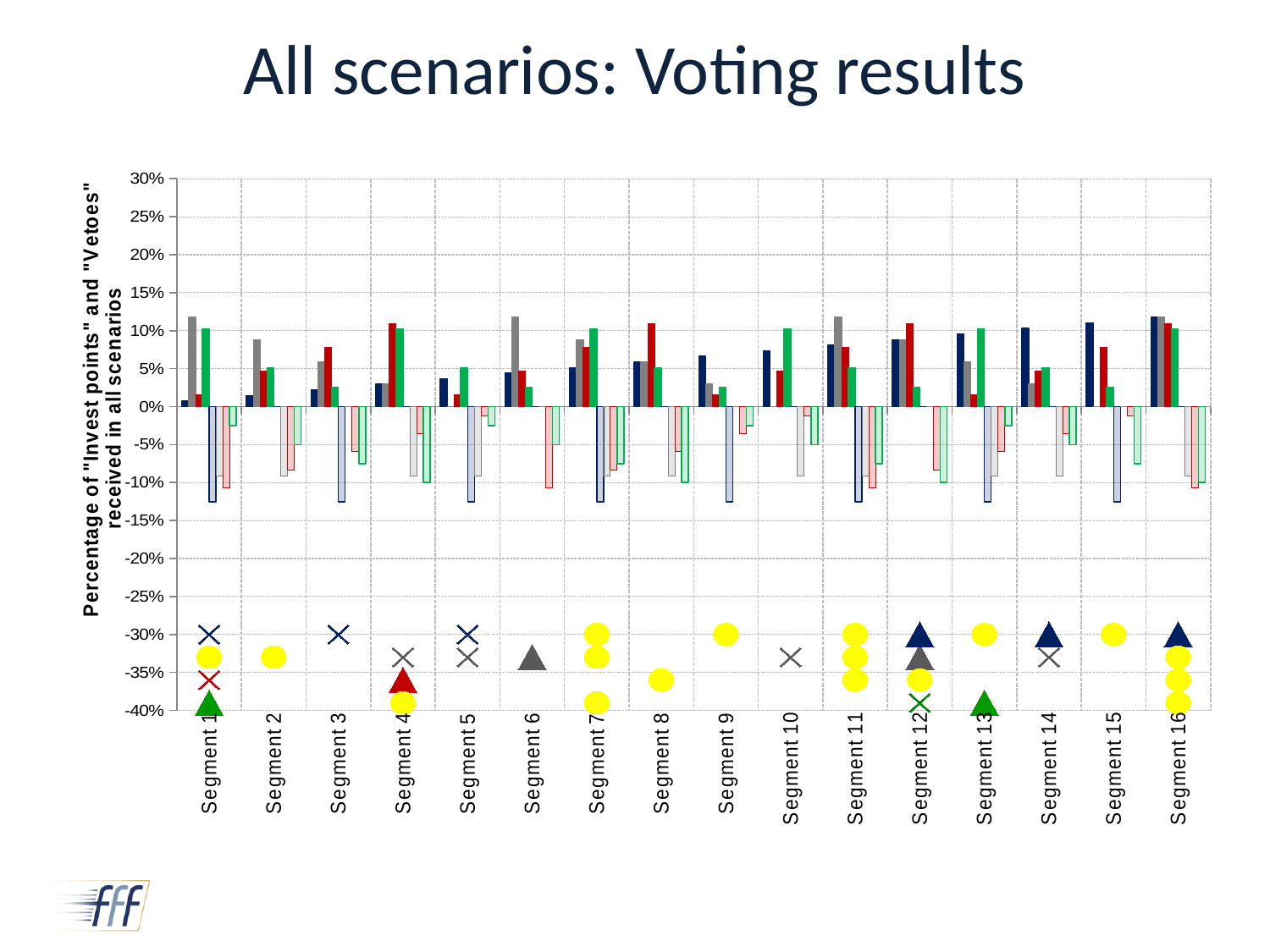
What is the title of the slide's chart? All scenarios: Voting results What kind of chart is shown on the slide? bar chart Which is larger: the dark blue bar for Segment 16 or the dark blue bar for Segment 2? Segment 16 Is the value of the gray bar for Segment 6 greater or less than 10%? greater What is the highest value shown on the chart's y axis? 30% For Segment 8, which bar is larger: the red bar or the green bar? the red bar Is the value of the light blue negative bar for Segment 1 greater or less than -10%? less Is the value of the green bar for Segment 9 greater or less than 5%? less How many segments are shown along the x axis of the chart? 16